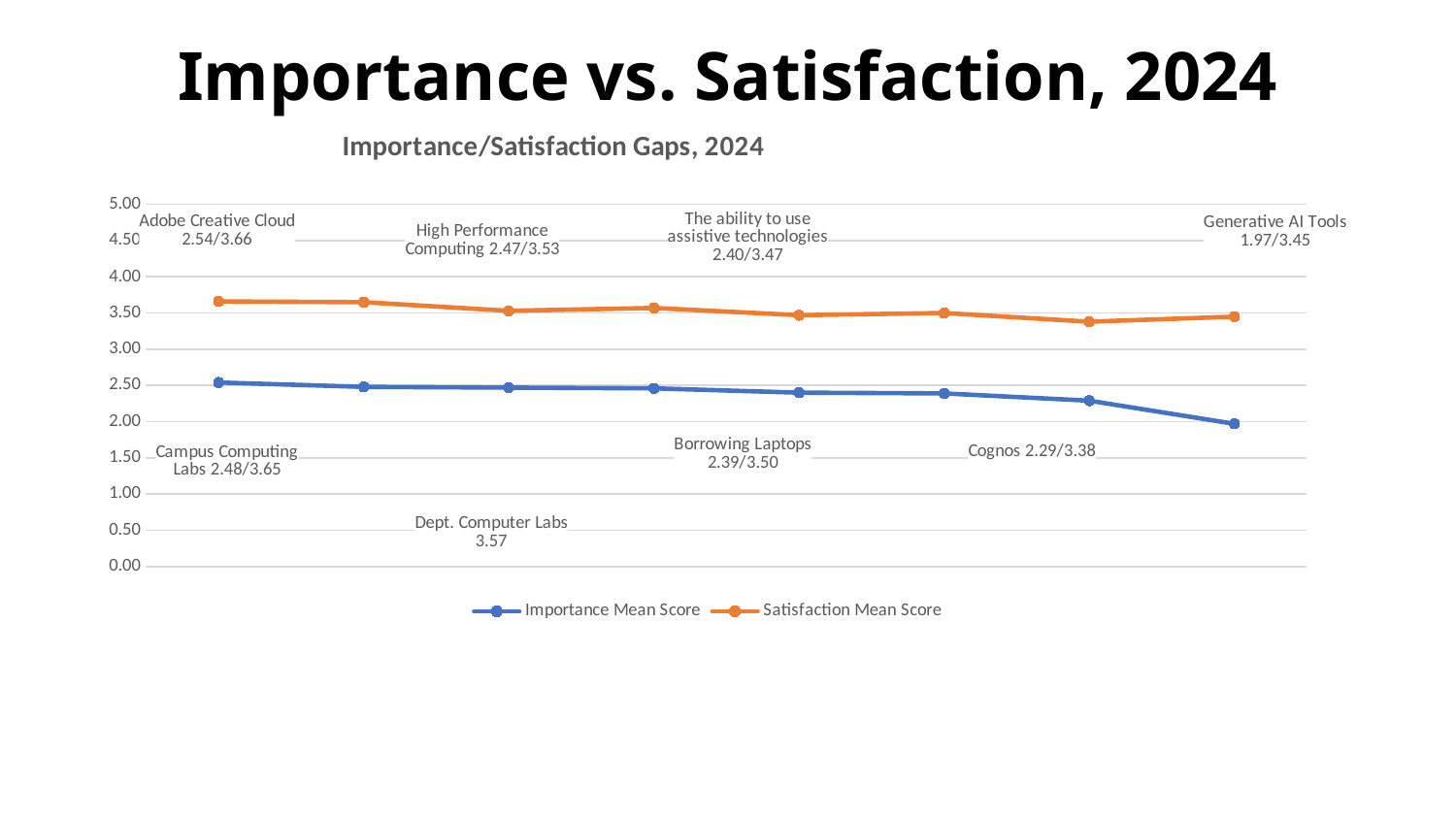
Is the Importance Mean Score for Adobe Creative Cloud greater or less than 3.00? less What is the difference between the Satisfaction Mean Score and the Importance Mean Score for Adobe Creative Cloud? 1.12 How many data points are plotted on each line? 8 What is the difference between the Satisfaction Mean Score and the Importance Mean Score for Cognos? 1.09 How many series does the legend list? 2 What kind of chart is shown on the slide? line chart What is the Satisfaction Mean Score for Generative AI Tools? 3.45 Does the Importance Mean Score line rise or fall from left to right across the x axis? fall Which has the higher Satisfaction Mean Score, Adobe Creative Cloud or Cognos? Adobe Creative Cloud What is the Satisfaction Mean Score for Cognos? 3.38 Which item has the lowest Importance Mean Score? Generative AI Tools What is the Importance Mean Score for Adobe Creative Cloud? 2.54